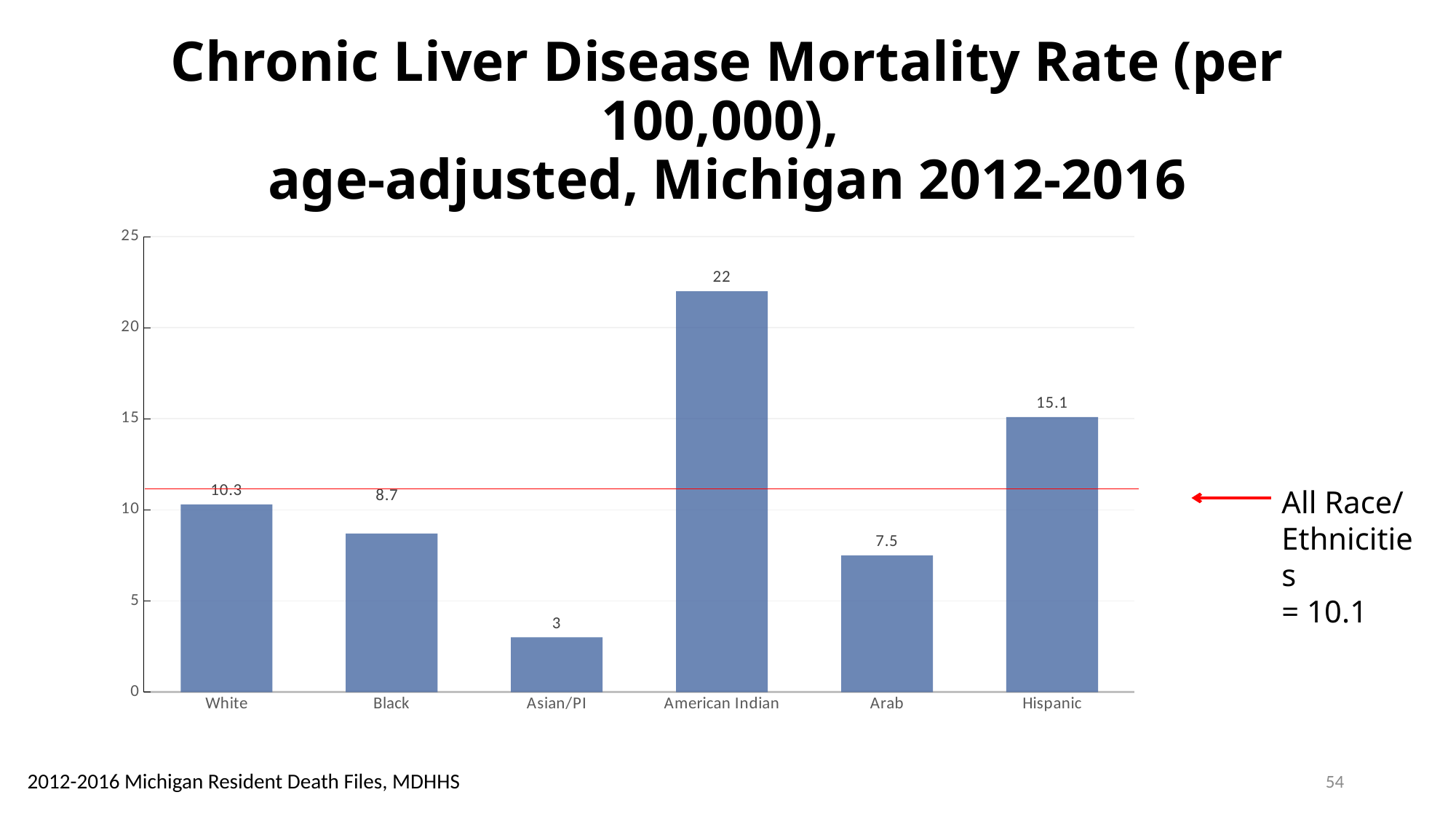
What is the chronic liver disease mortality rate for Asian/PI? 3 Which race/ethnicity has the lowest chronic liver disease mortality rate? Asian/PI Is the value for Hispanic greater or less than 10? greater What kind of chart is shown on the slide? bar chart What is the mortality rate for All Race/Ethnicities indicated by the horizontal line? 10.1 What is the difference between the mortality rates for White and Black? 1.6 What is the chronic liver disease mortality rate for American Indian? 22 Which race/ethnicity has the highest chronic liver disease mortality rate? American Indian Which has a higher chronic liver disease mortality rate, Arab or Black? Black What is the chronic liver disease mortality rate for Hispanic? 15.1 What is the difference between the mortality rates for American Indian and Hispanic? 6.9 How many race/ethnicity categories are shown on the chart? 6